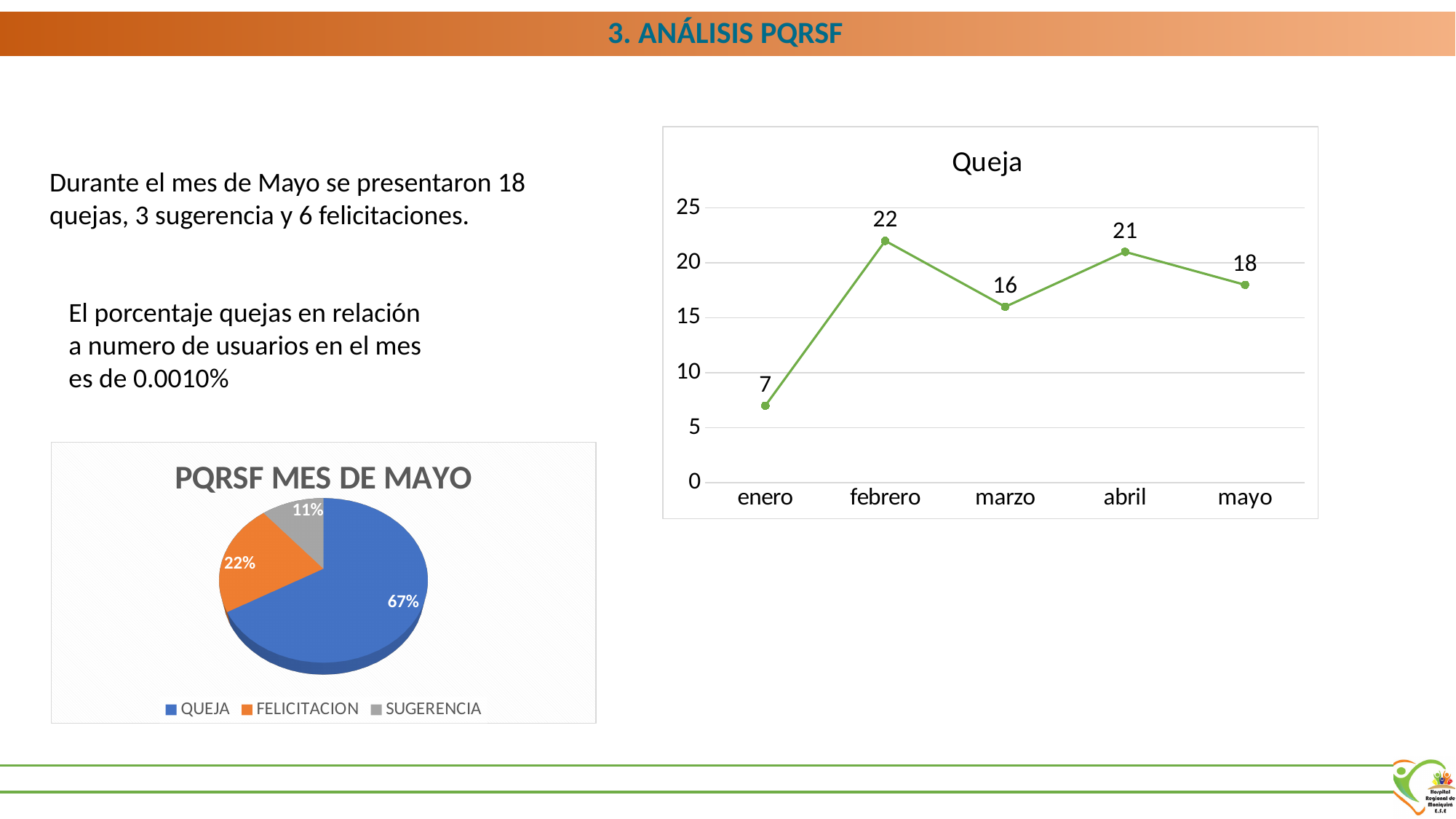
What kind of chart is the 'Queja' chart? line chart In the 'Queja' line chart, which month has the highest value? febrero In the 'Queja' line chart, what is the value for enero? 7 In the 'Queja' line chart, what is the difference between the values for abril and marzo? 5 How many entries does the legend of the 'PQRSF MES DE MAYO' pie chart list? 3 In the 'Queja' line chart, does the value rise or fall from abril to mayo? fall In the 'Queja' line chart, what is the value for febrero? 22 In the 'Queja' line chart, which is larger, the value for marzo or the value for mayo? mayo In the 'PQRSF MES DE MAYO' pie chart, which category has the smallest slice? SUGERENCIA In the 'Queja' line chart, which month has the lowest value? enero In the 'PQRSF MES DE MAYO' pie chart, what share does QUEJA have? 67% In the 'Queja' line chart, how many months are plotted on the x axis? 5